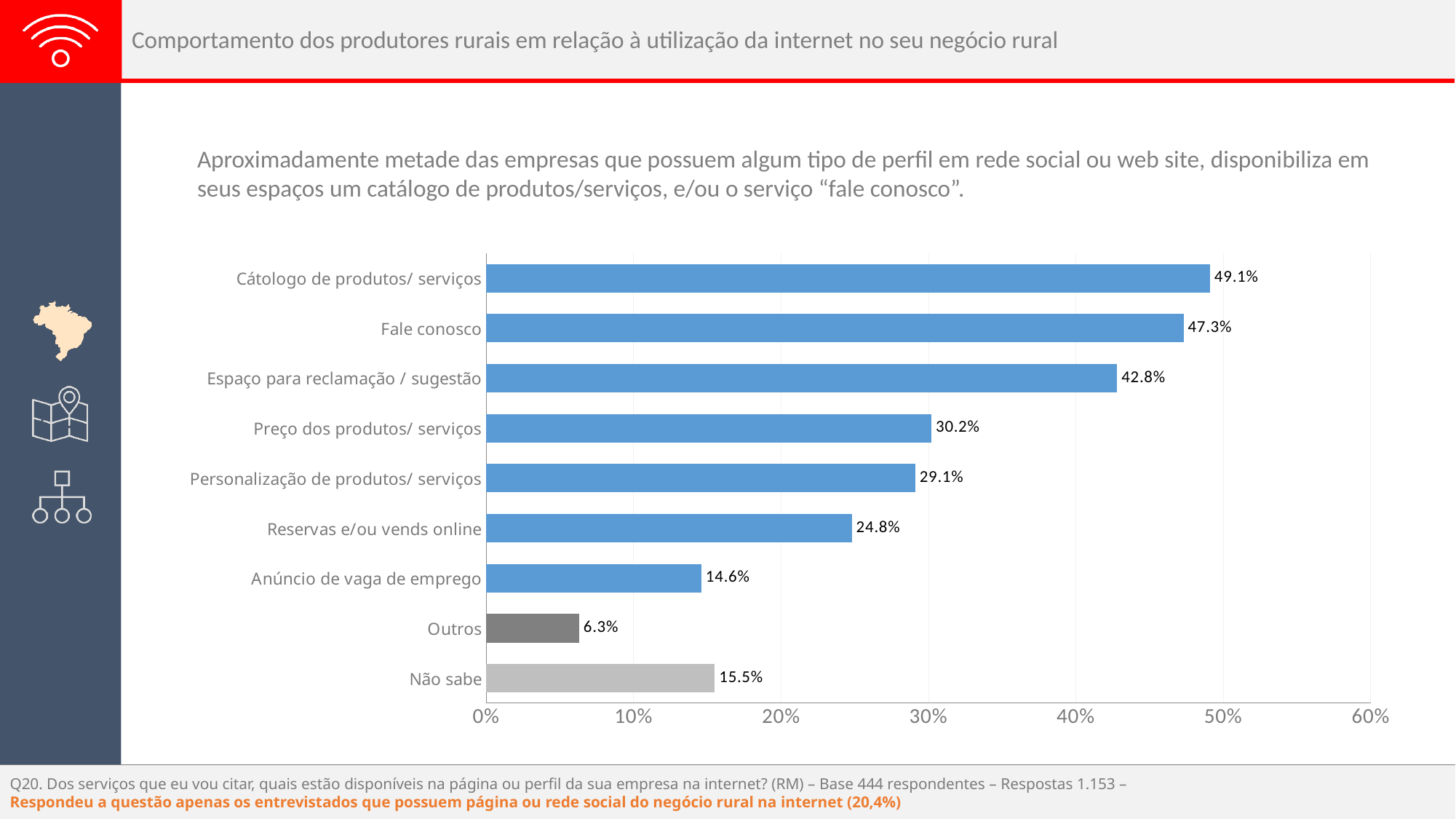
Is the value for "Espaço para reclamação / sugestão" greater or less than 40%? greater What is the value for "Fale conosco"? 47.3% What is the difference between "Preço dos produtos/ serviços" and "Anúncio de vaga de emprego"? 15.6% What is the difference between "Cátologo de produtos/ serviços" and "Fale conosco"? 1.8% Which is larger, "Não sabe" or "Anúncio de vaga de emprego"? Não sabe What is the value for "Reservas e/ou vends online"? 24.8% What is the value for "Não sabe"? 15.5% What is the maximum value shown on the x axis? 60% How many categories are shown in the chart? 9 Which category has the highest value? Cátologo de produtos/ serviços Which category has the lowest value? Outros What kind of chart is shown on the slide? bar chart